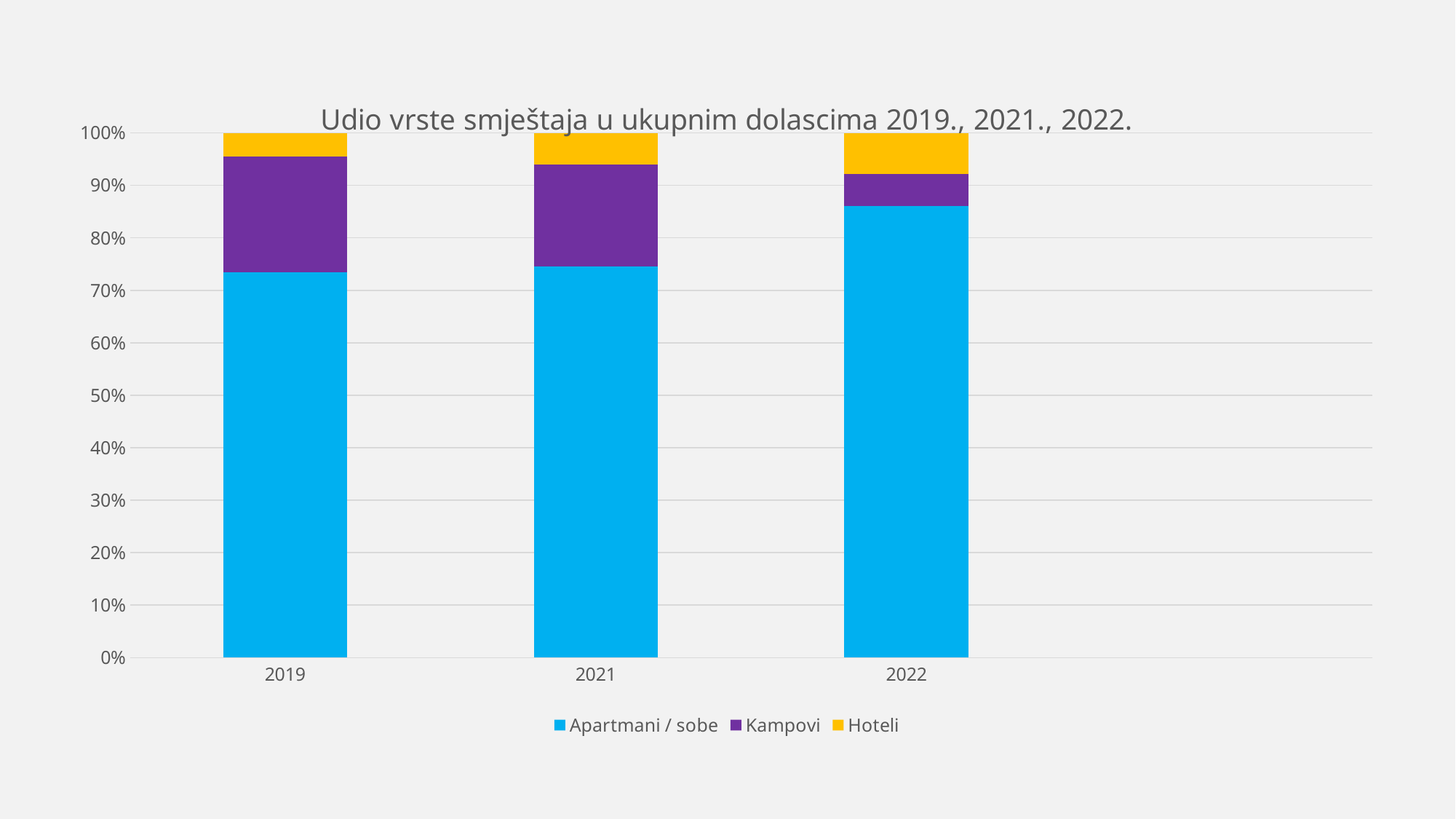
Is the share of Kampovi in 2022 greater or less than 10%? less Is the share of Apartmani / sobe in 2019 greater or less than 70%? greater Is the share of Apartmani / sobe in 2022 greater or less than 80%? greater In which year is the share of Kampovi the lowest? 2022 Which series is shown in yellow in the chart? Hoteli In which year is the share of Apartmani / sobe the highest? 2022 What kind of chart is shown on the slide? Stacked bar chart How many series does the legend list? 3 How many years are shown on the x axis of the chart? 3 Does the share of Apartmani / sobe rise or fall from 2019 to 2022? rise What is the title of the chart? Udio vrste smještaja u ukupnim dolascima 2019., 2021., 2022. Which is larger: the share of Hoteli in 2022 or in 2019? 2022